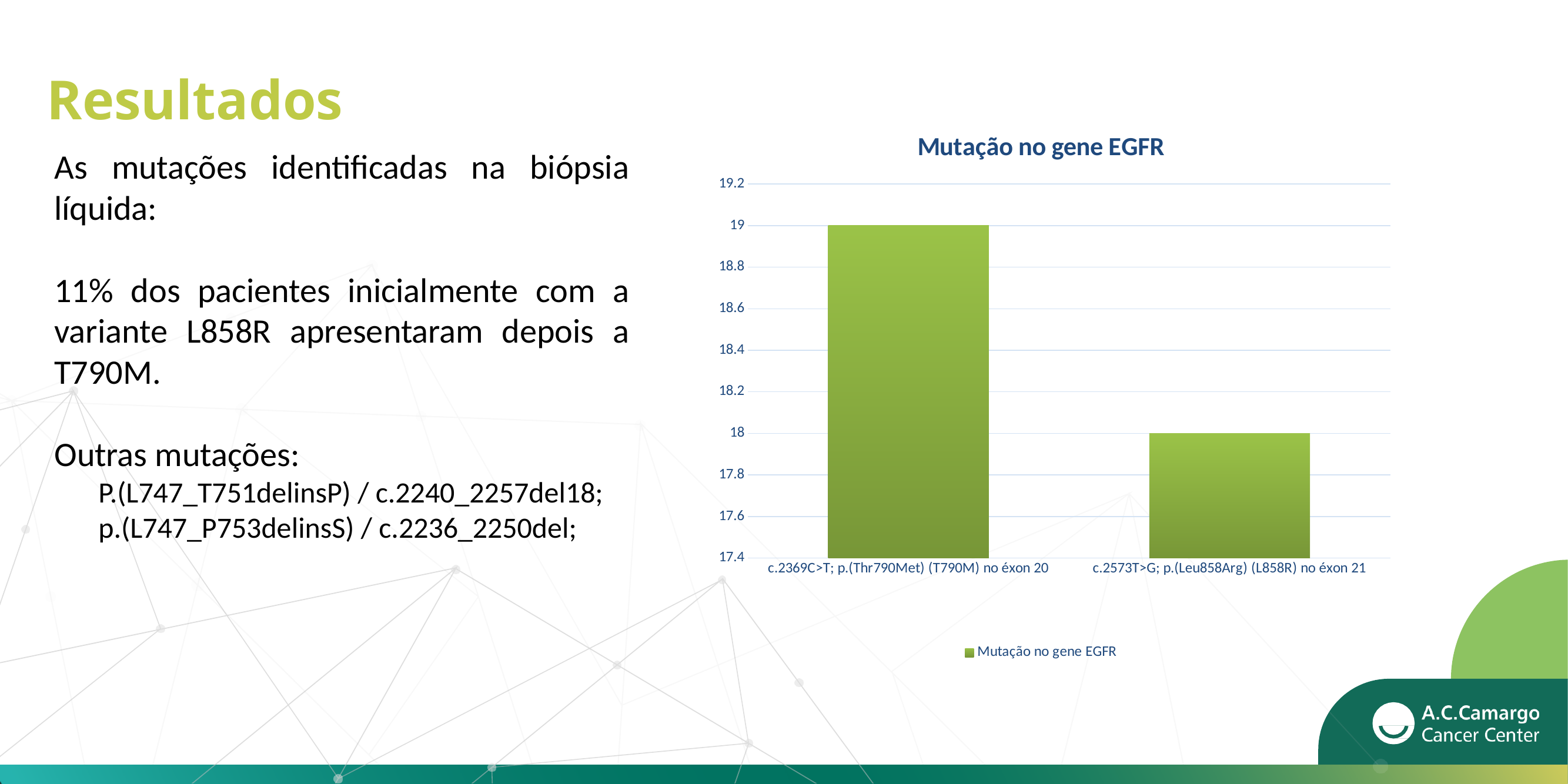
What is the difference between the value for T790M no éxon 20 and the value for L858R no éxon 21? 1 What is the value for c.2573T>G; p.(Leu858Arg) (L858R) no éxon 21? 18 Do the values rise or fall from left to right along the x axis? fall Which category has the highest value? c.2369C>T; p.(Thr790Met) (T790M) no éxon 20 Which is larger: the value for T790M no éxon 20 or the value for L858R no éxon 21? T790M no éxon 20 How many series does the legend list? 1 Is the value for c.2573T>G; p.(Leu858Arg) (L858R) no éxon 21 greater or less than 18.4? less How many bars (categories) does the chart show? 2 Which category has the lowest value? c.2573T>G; p.(Leu858Arg) (L858R) no éxon 21 What is the value for c.2369C>T; p.(Thr790Met) (T790M) no éxon 20? 19 What is the title of the chart? Mutação no gene EGFR What type of chart is shown on the slide? bar chart